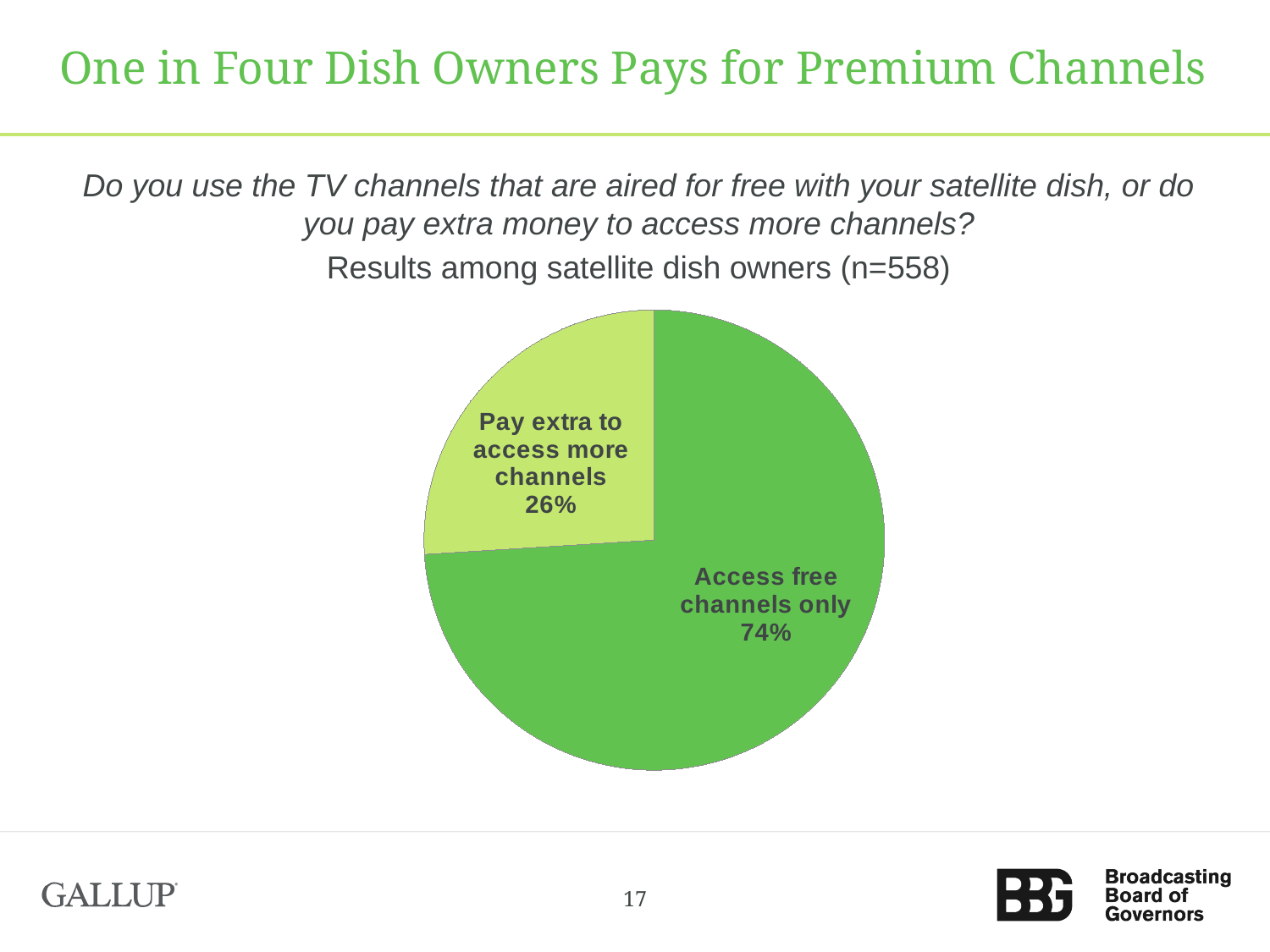
Which slice of the pie chart is the largest? Access free channels only How many slices does the pie chart have? 2 What share of the pie does the 'Pay extra to access more channels' slice represent? 26% What is the difference in percentage points between those who access free channels only and those who pay extra to access more channels? 48 What percentage of satellite dish owners pay extra to access more channels? 26% What is the sample size (n) of satellite dish owners shown on the slide? 558 What percentage of satellite dish owners access free channels only? 74% What kind of chart is shown on the slide? Pie chart Which is larger: the share that accesses free channels only or the share that pays extra to access more channels? Access free channels only Which slice of the pie chart is the smallest? Pay extra to access more channels What is the title of the slide? One in Four Dish Owners Pays for Premium Channels